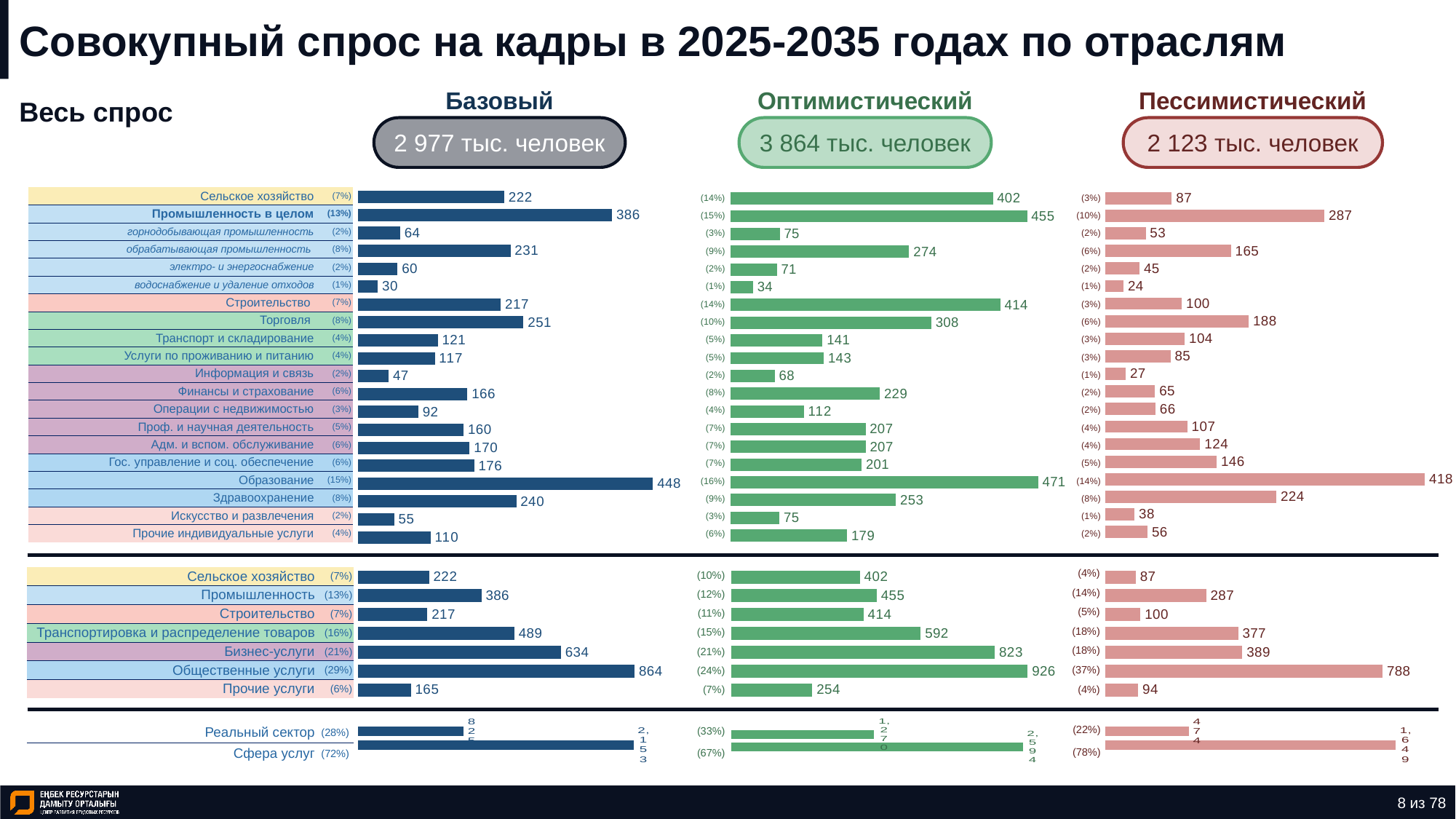
How many categories are shown in the middle section (from Сельское хозяйство to Прочие услуги) of the Базовый chart? 7 In the Оптимистический chart, what is the value for Строительство? 414 In the Пессимистический chart, what is the difference between Промышленность в целом and Сельское хозяйство? 200 In the Базовый chart, what is the value for Общественные услуги? 864 In the Пессимистический chart, what is the value for Здравоохранение? 224 What type of chart is used to show the demand by industry on this slide? Bar chart In the Пессимистический chart, which industry in the top section has the lowest value? водоснабжение и удаление отходов What is the difference between the Образование value in the Оптимистический chart and in the Базовый chart? 23 In the Оптимистический chart, what is the value for Бизнес-услуги? 823 In the Базовый chart, which is larger: Торговля or Строительство? Торговля In the Базовый chart, what is the value for Образование? 448 In the Базовый chart, which industry in the top section has the highest value? Образование